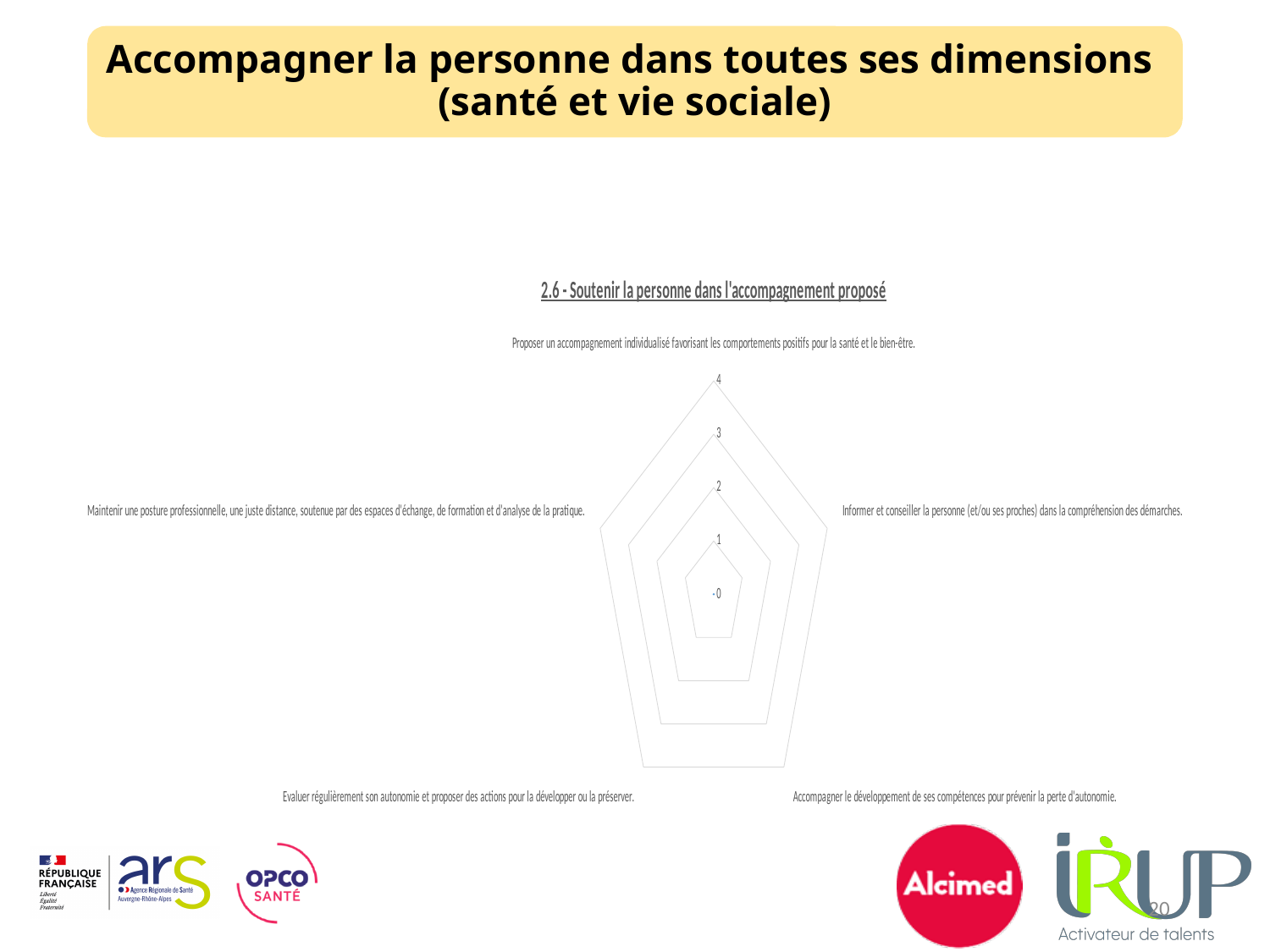
Which category label appears on the right side of the radar chart? Informer et conseiller la personne (et/ou ses proches) dans la compréhension des démarches. What is the highest value shown on the radar chart's axis scale? 4 Which category label appears on the left side of the radar chart? Maintenir une posture professionnelle, une juste distance, soutenue par des espaces d'échange, de formation et d'analyse de la pratique. What is the lowest value shown on the radar chart's axis scale? 0 Which category label appears at the top of the radar chart? Proposer un accompagnement individualisé favorisant les comportements positifs pour la santé et le bien-être. What is the title of the radar chart? 2.6 - Soutenir la personne dans l'accompagnement proposé What kind of chart is shown on the slide? radar chart How many tick values are labelled on the radar chart's axis scale? 5 How many categories (axes) does the radar chart have? 5